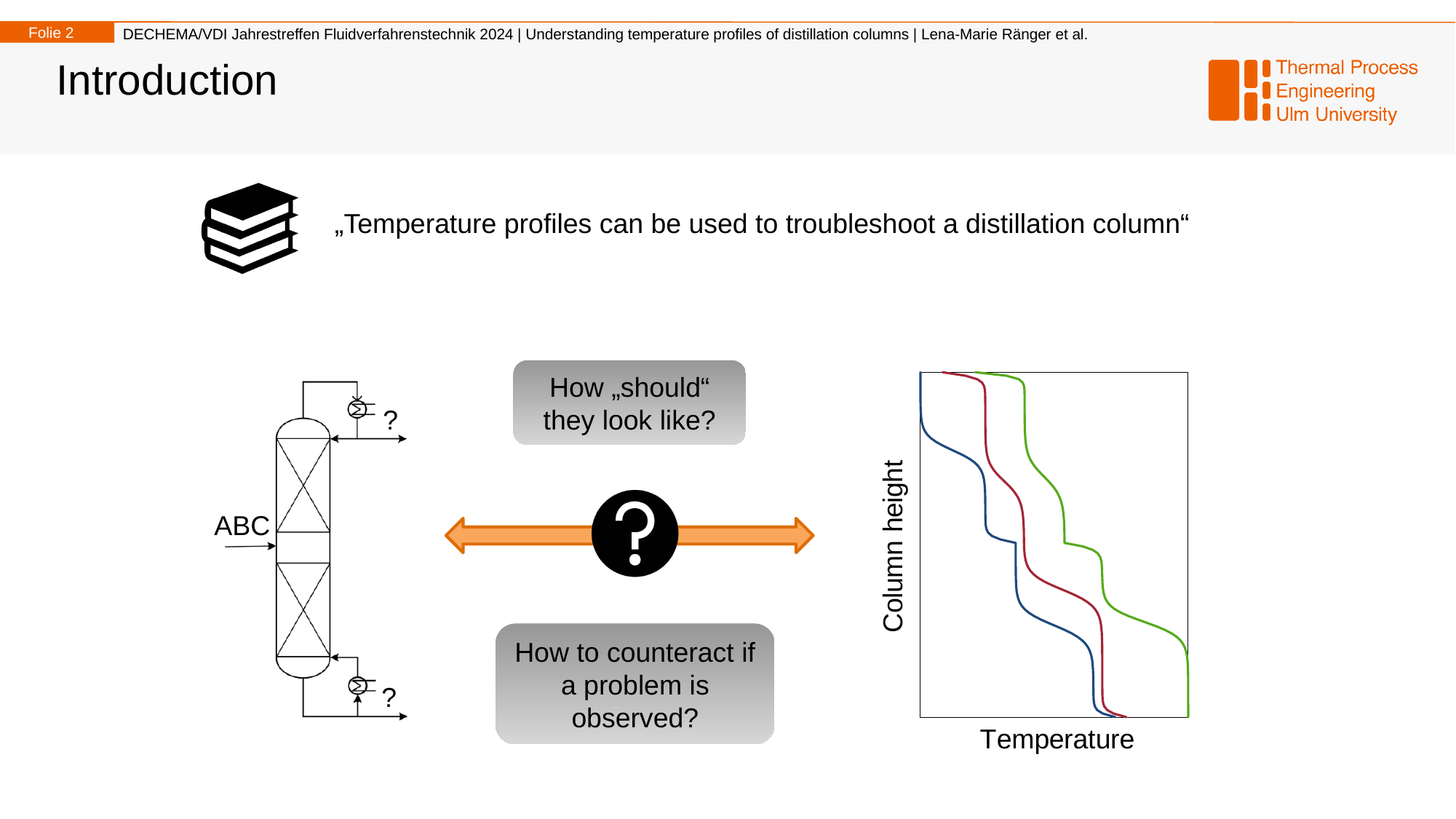
What is the label of the vertical axis of the chart on the right? Column height What is the label of the horizontal axis of the chart on the right? Temperature In the chart on the right, which curve lies furthest to the right (highest temperature) at the bottom of the column: the blue, red or green one? Green How many curves are plotted in the chart on the right? 3 In the chart on the right, does column height rise or fall as temperature increases along the x axis? Fall In the chart on the right, which curve lies furthest to the left (lowest temperature) at the top of the column: the blue, red or green one? Blue What kind of chart is shown on the right side of the slide? Line chart